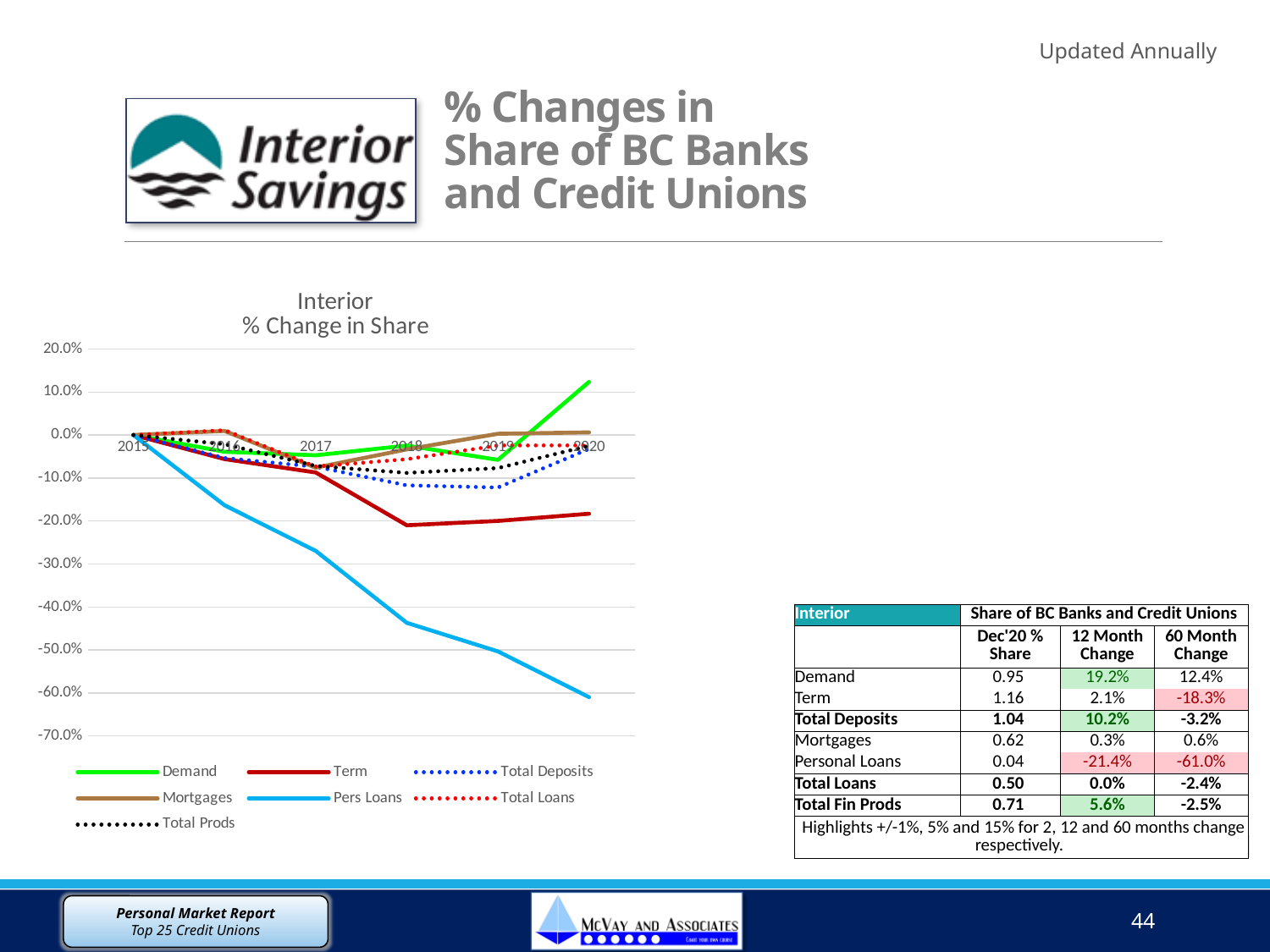
Is the value for Pers Loans in 2020 greater or less than -50.0%? less What kind of chart is shown on the slide? line chart Is the value for Term in 2020 greater or less than -10.0%? less Which series is drawn as a solid green line? Demand How many series does the chart legend list? 7 How many years are plotted along the x axis of the chart? 6 Is the value for Demand in 2020 greater or less than 0.0%? greater In 2018, which is higher: Term or Pers Loans? Term Which series has the highest value in 2020? Demand What is the title of the chart? Interior % Change in Share Which series has the lowest value in 2020? Pers Loans Does the Pers Loans line rise or fall from 2015 to 2020? fall